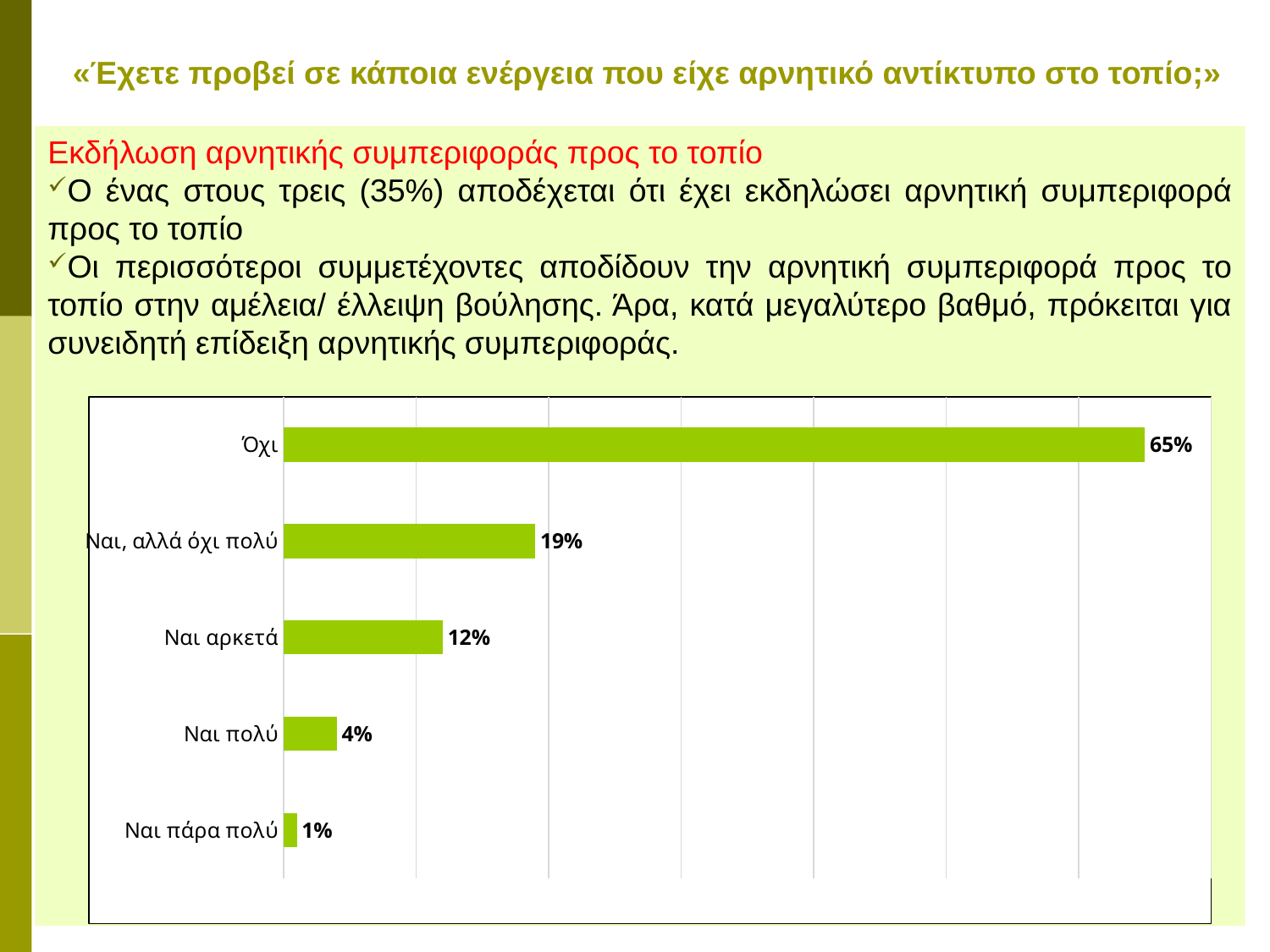
Which is larger, the value for Ναι αρκετά or the value for Ναι πολύ? Ναι αρκετά What is the difference between the values for Όχι and Ναι, αλλά όχι πολύ? 46% Which category has the lowest value? Ναι πάρα πολύ What is the value for Όχι? 65% What is the value for Ναι πάρα πολύ? 1% What kind of chart is shown on the slide? Bar chart How many categories are shown in the chart? 5 What is the value for Ναι αρκετά? 12% What is the value for Ναι πολύ? 4% What colour are the bars in the chart? Green What is the value for Ναι, αλλά όχι πολύ? 19% Which category has the highest value? Όχι